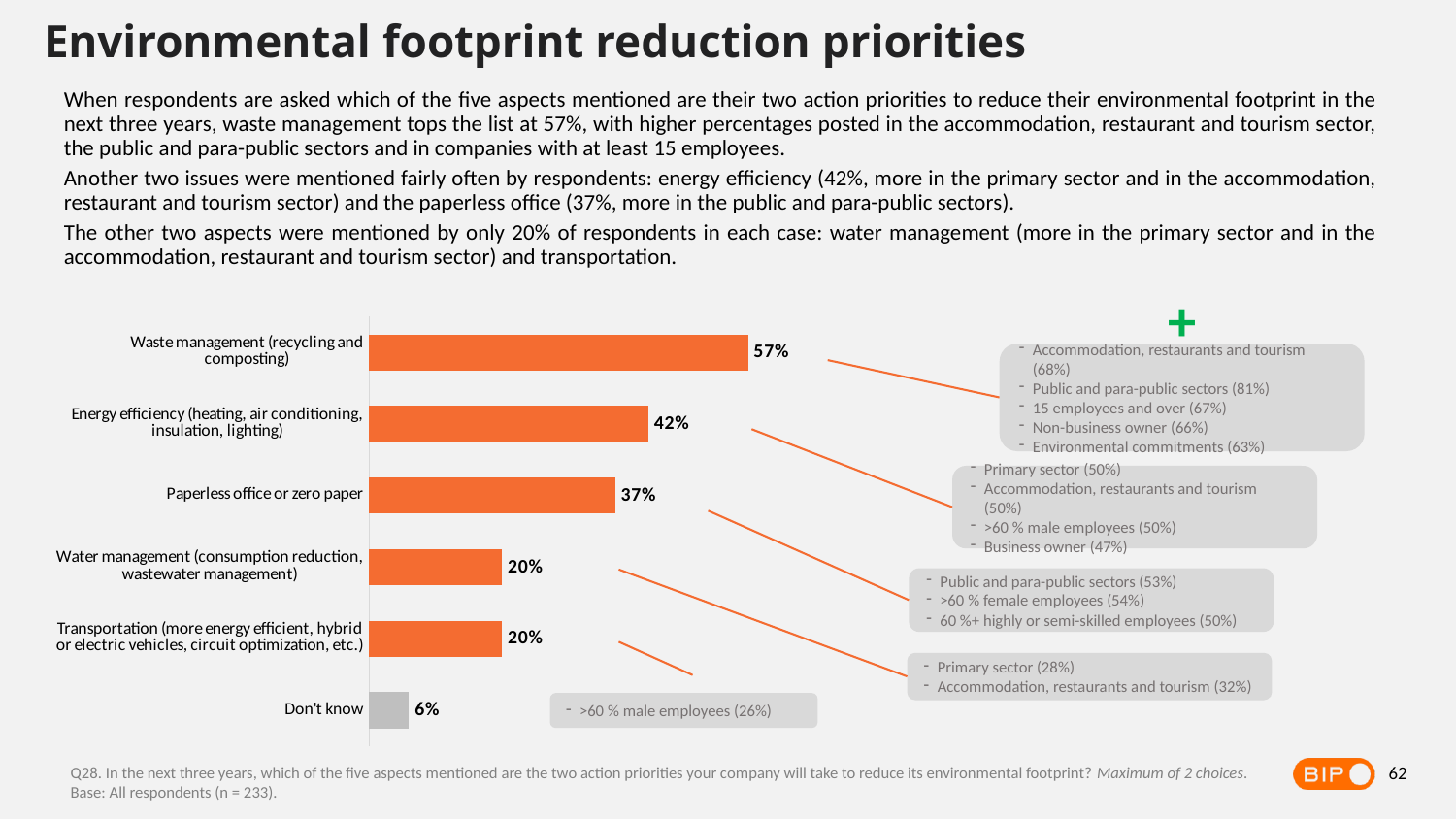
What is the value for the 'Don't know' category? 6% What percentage is shown for paperless office or zero paper? 37% Which category has the highest value in the chart? Waste management (recycling and composting) How many categories are shown in the chart? 6 What is the value shown for energy efficiency (heating, air conditioning, insulation, lighting)? 42% What is the difference between the values for paperless office and water management? 17% Which is larger: the value for energy efficiency or the value for paperless office? Energy efficiency What percentage of respondents chose waste management (recycling and composting) as an action priority? 57% What is the difference between the values for waste management and energy efficiency? 15% Which category has the lowest value in the chart? Don't know What kind of chart is shown on the slide? Bar chart Which category's bar is shown in grey rather than orange? Don't know